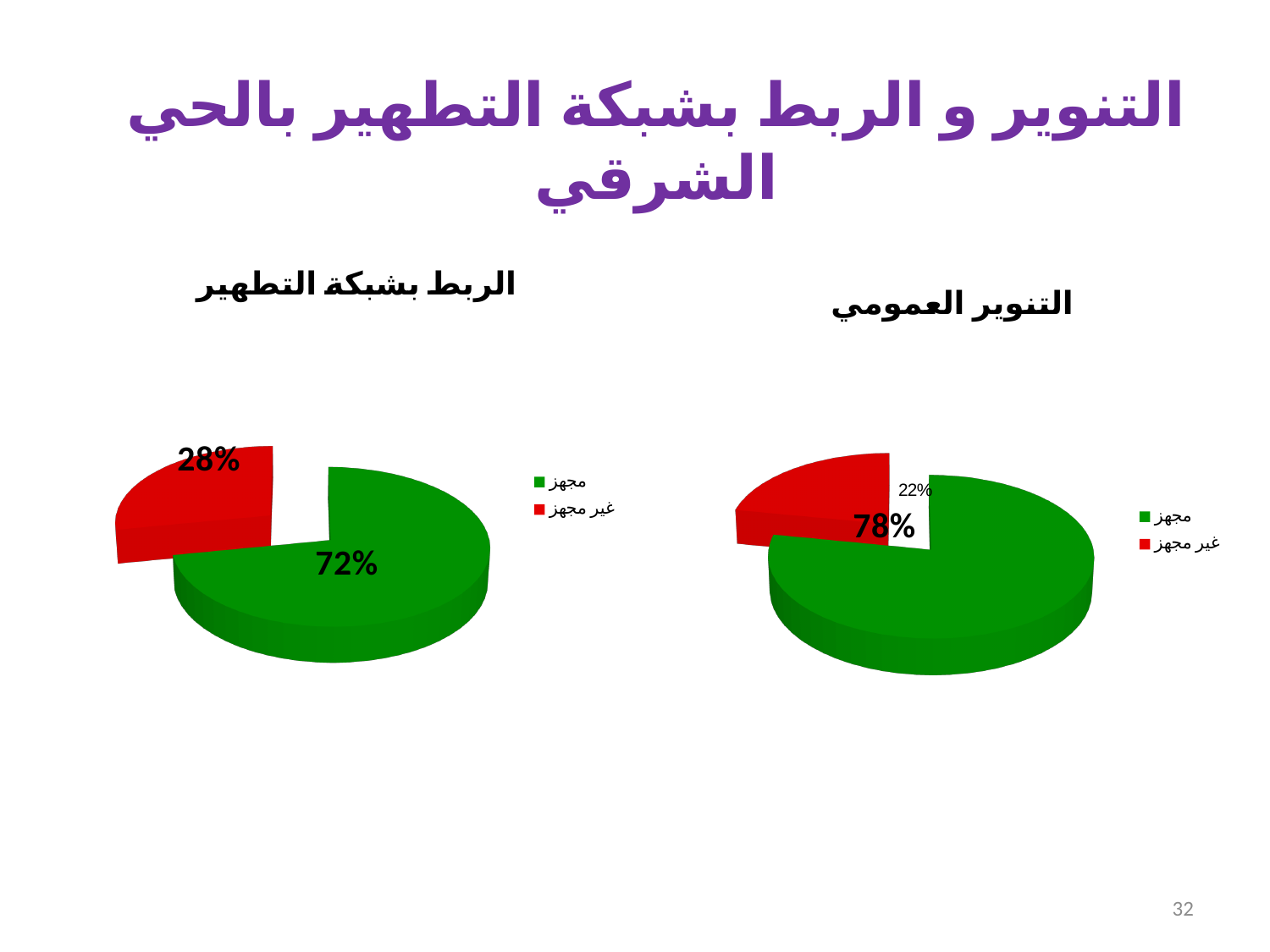
In the right chart (التنوير العمومي), what share is labelled for غير مجهز? 22% In the left chart (الربط بشبكة التطهير), what share is labelled for مجهز? 72% In the right chart (التنوير العمومي), which slice is the smallest? غير مجهز In the left chart (الربط بشبكة التطهير), which slice is the largest? مجهز In the left chart (الربط بشبكة التطهير), what share is labelled for غير مجهز? 28% In the right chart (التنوير العمومي), what is the difference between the مجهز and غير مجهز shares? 56% In the left chart (الربط بشبكة التطهير), what is the difference between the مجهز and غير مجهز shares? 44% Which chart has the larger مجهز share, the left chart (الربط بشبكة التطهير) or the right chart (التنوير العمومي)? التنوير العمومي In the right chart (التنوير العمومي), what share is labelled for مجهز? 78% What type of charts are shown on the slide? Pie charts Which colour represents غير مجهز in the legends of both charts? Red How many slices does each pie chart on the slide have? 2